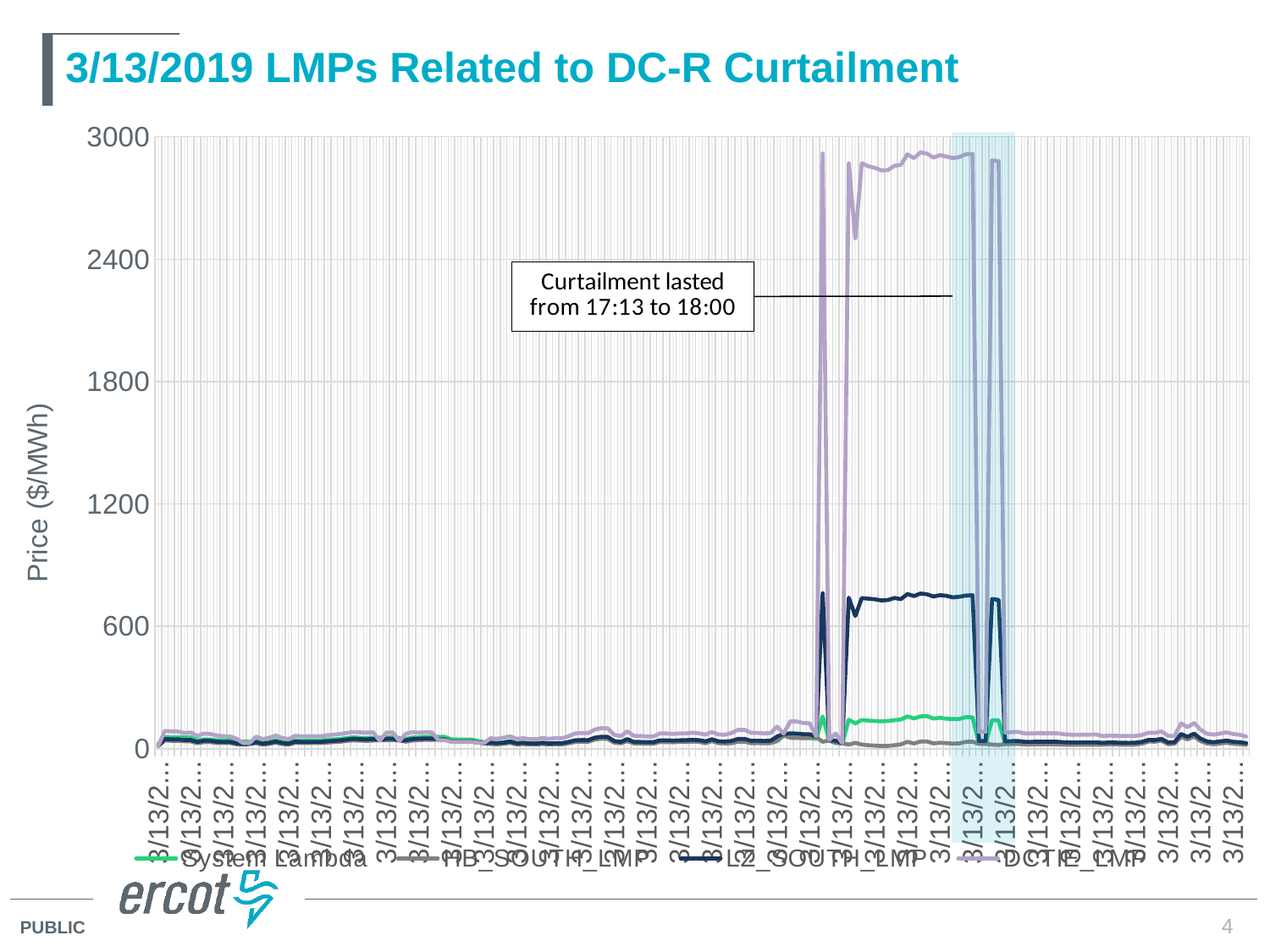
Which series stays lowest during the price spike period? HB_SOUTH_LMP What is the title of the chart? 3/13/2019 LMPs Related to DC-R Curtailment Is the peak value of L2_SOUTH_LMP greater or less than 600? greater What does the annotation box on the chart say? Curtailment lasted from 17:13 to 18:00 Is the peak value of DCTIE_LMP greater or less than 2400? greater Which series has the larger peak value, DCTIE_LMP or L2_SOUTH_LMP? DCTIE_LMP Is the highest value of HB_SOUTH_LMP greater or less than 600? less Which series reaches the highest value on the chart? DCTIE_LMP How many series does the legend list? 4 What kind of chart is shown on the slide? line chart